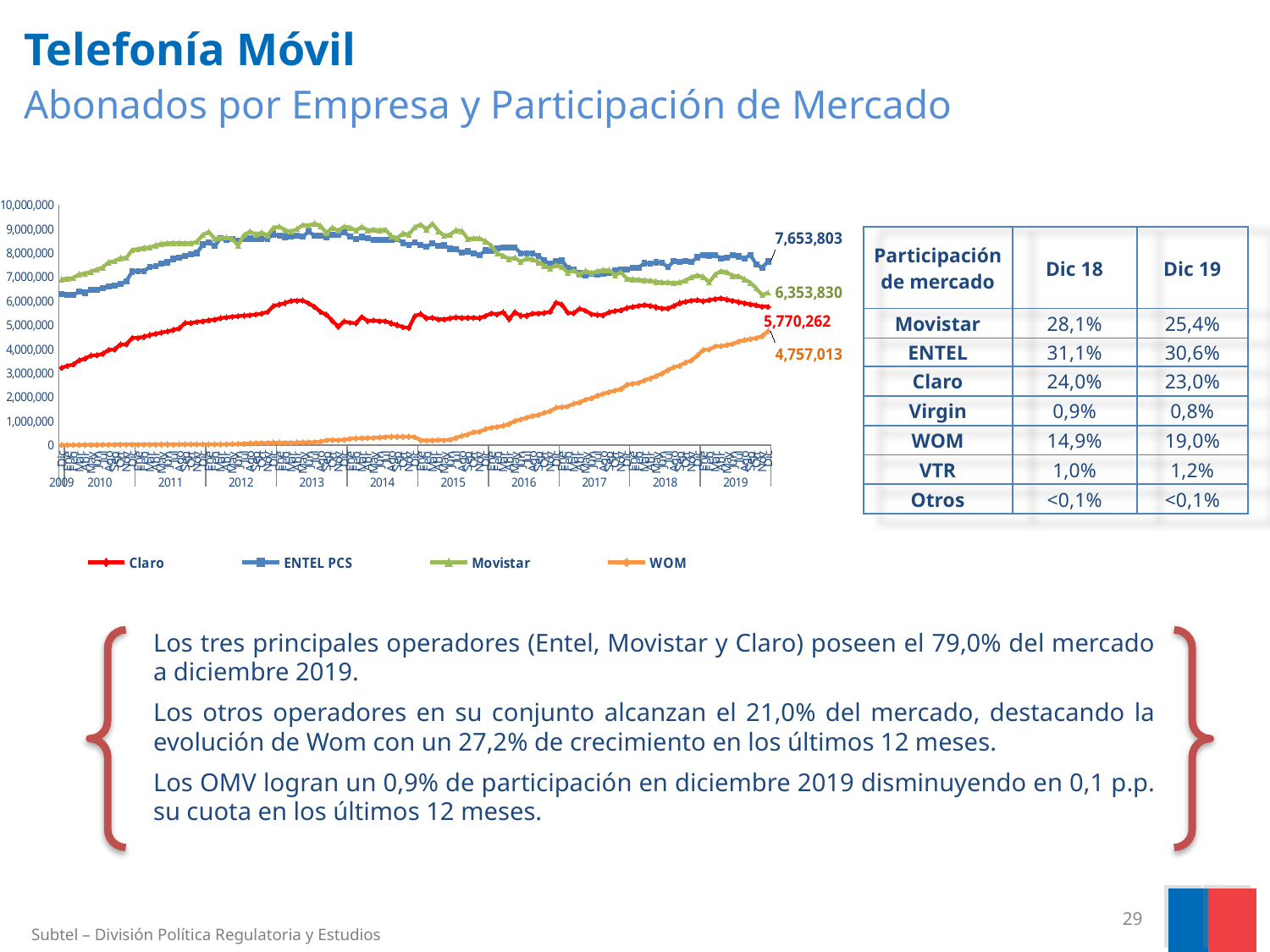
How many series does the legend list? 4 What is the final labelled value for the Movistar series? 6,353,830 Is the value for WOM in 2009 greater or less than 1,000,000? less What is the final labelled value for the ENTEL PCS series? 7,653,803 At the end of the chart, which is larger: the Movistar value or the Claro value? Movistar What is the final labelled value for the Claro series? 5,770,262 What is the difference between the final labelled values of ENTEL PCS and Movistar? 1,299,973 What is the final labelled value for the WOM series? 4,757,013 What kind of chart is shown on the slide? line chart Which series has the highest value at the end of the chart (2019)? ENTEL PCS Does the WOM series rise or fall from 2015 to 2019? rise Which series has the lowest value at the end of the chart (2019)? WOM